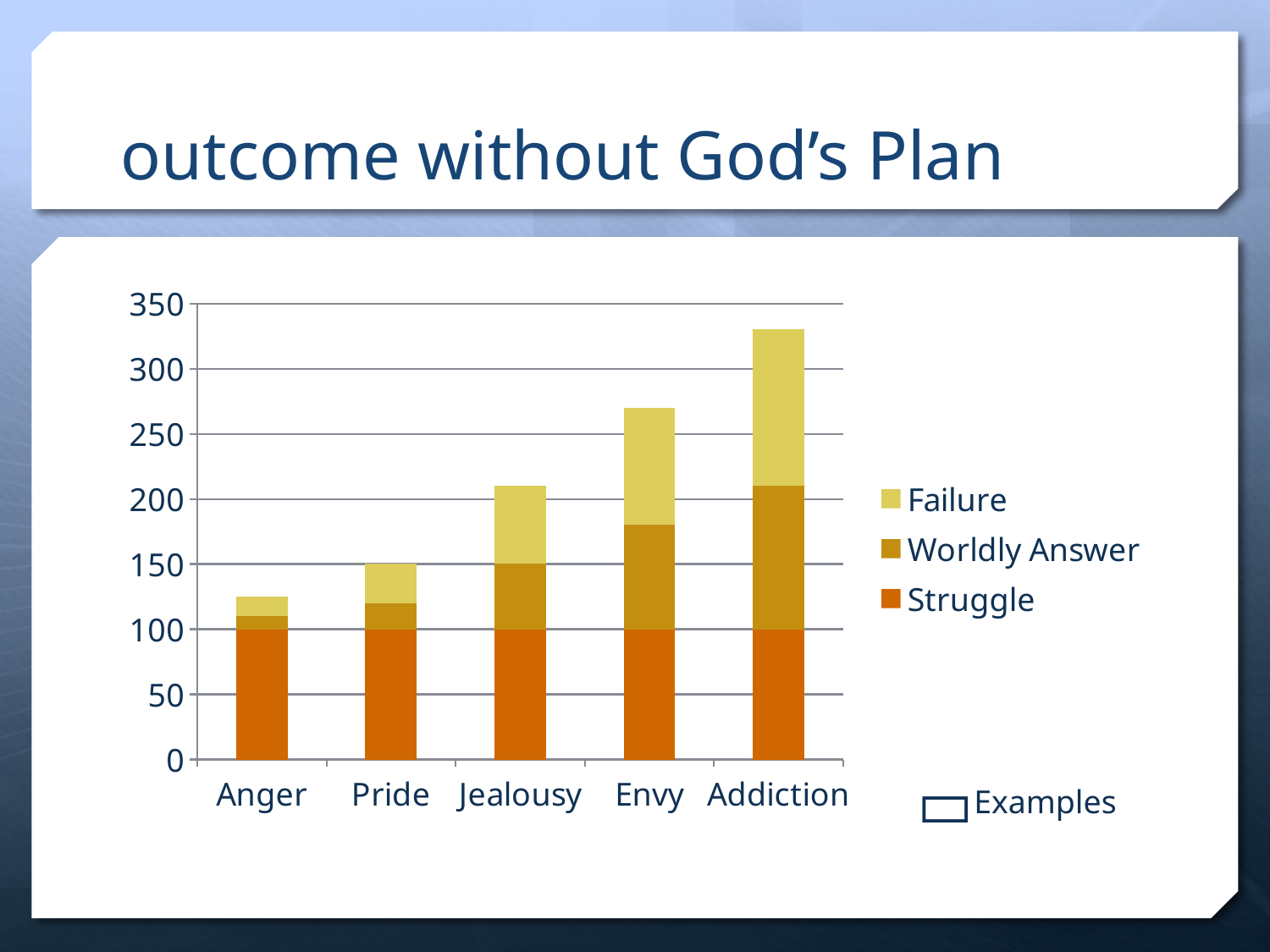
What is the value of the Struggle segment for Anger? 100 Which has the larger total, Envy or Pride? Envy How many series does the chart legend list? 3 Which category has the shortest stacked bar? Anger Which category has the tallest stacked bar? Addiction Is the total for Anger greater or less than 150? less How many categories are shown on the x axis of the chart? 5 What is the total height of the stacked bar for Pride? 150 Is the total for Addiction greater or less than 300? greater What kind of chart is shown on the slide? Stacked bar chart Do the stacked bar totals rise or fall from Anger to Addiction along the x axis? Rise What is the title of the slide containing the chart? outcome without God's Plan